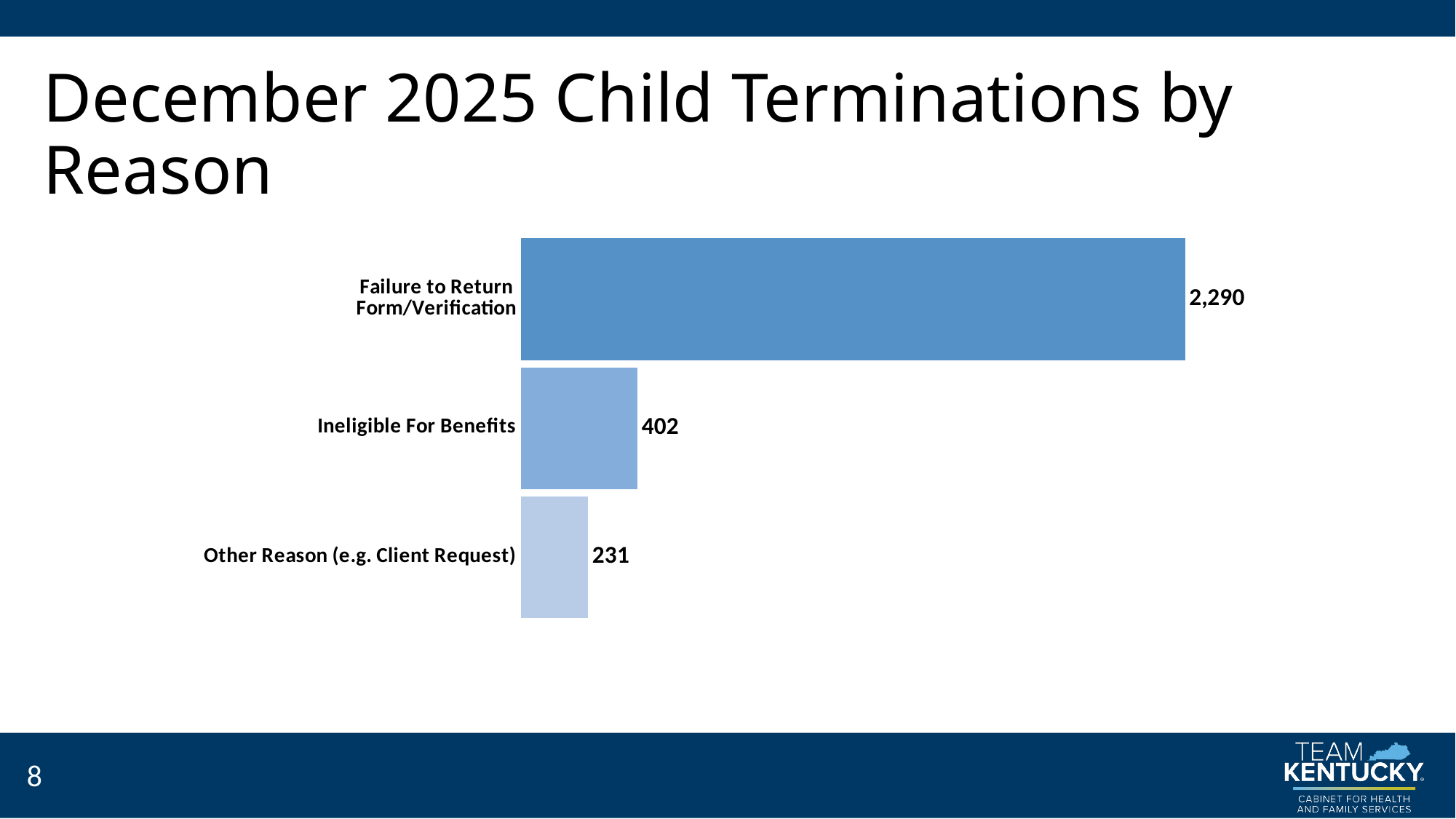
Which reason has the lowest number of child terminations? Other Reason (e.g. Client Request) What is the value for Failure to Return Form/Verification? 2,290 What is the difference between the values for Failure to Return Form/Verification and Ineligible For Benefits? 1,888 What kind of chart is shown on the slide? Bar chart What is the total of the three values shown in the chart? 2,923 What is the value for Other Reason (e.g. Client Request)? 231 What is the value for Ineligible For Benefits? 402 How many reason categories are shown in the chart? 3 What is the title of the slide? December 2025 Child Terminations by Reason What is the difference between the values for Ineligible For Benefits and Other Reason (e.g. Client Request)? 171 Which is larger, the value for Ineligible For Benefits or the value for Other Reason (e.g. Client Request)? Ineligible For Benefits Which reason has the highest number of child terminations? Failure to Return Form/Verification